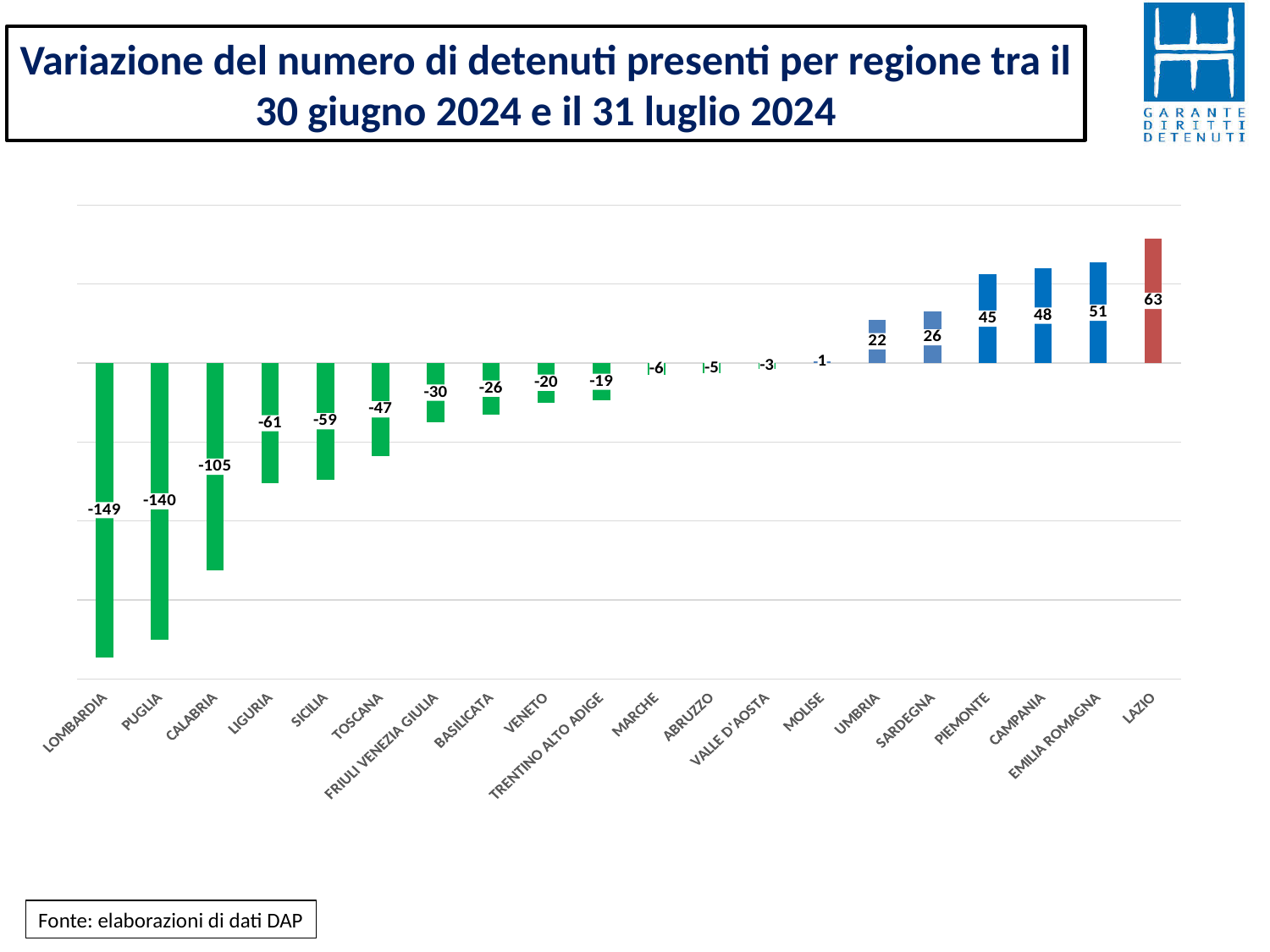
What is the value shown for LAZIO? 63 What is the value shown for SARDEGNA? 26 How many regions are shown in the chart? 20 Which region has the lowest value in the chart? LOMBARDIA Which has a larger value, PIEMONTE or EMILIA ROMAGNA? EMILIA ROMAGNA What is the value shown for LOMBARDIA? -149 Do the values rise or fall moving from left to right along the x axis? Rise What is the difference between the values for PUGLIA and CALABRIA? 35 Which region has the highest value in the chart? LAZIO What kind of chart is shown on the slide? Bar chart What is the value shown for TOSCANA? -47 What is the difference between the values for LAZIO and LOMBARDIA? 212